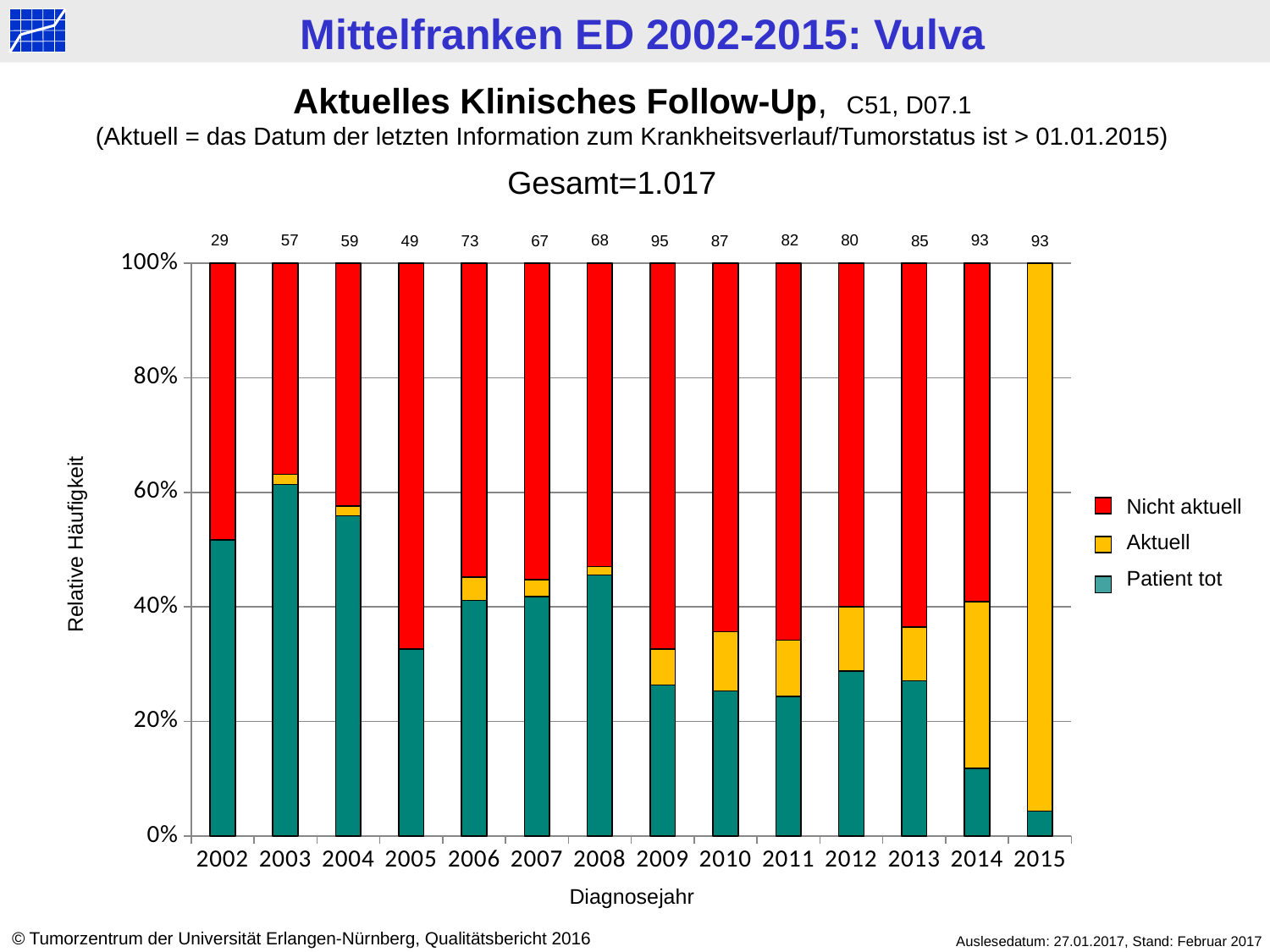
How many series does the legend list? 3 Is the 'Patient tot' share for 2014 greater or less than 20%? less Which year has the lowest number printed above its bar? 2002 Which year has the larger number printed above its bar, 2006 or 2007? 2006 What is the number printed above the bar for 2009? 95 What kind of chart is shown on the slide? bar chart What is the number printed above the bar for 2014? 93 What is the number printed above the bar for 2002? 29 How many diagnosis years (Diagnosejahr) are shown on the x axis? 14 Which legend entry is shown in red? Nicht aktuell Which year has the highest number printed above its bar? 2009 What is the difference between the numbers printed above the bars for 2009 and 2002? 66